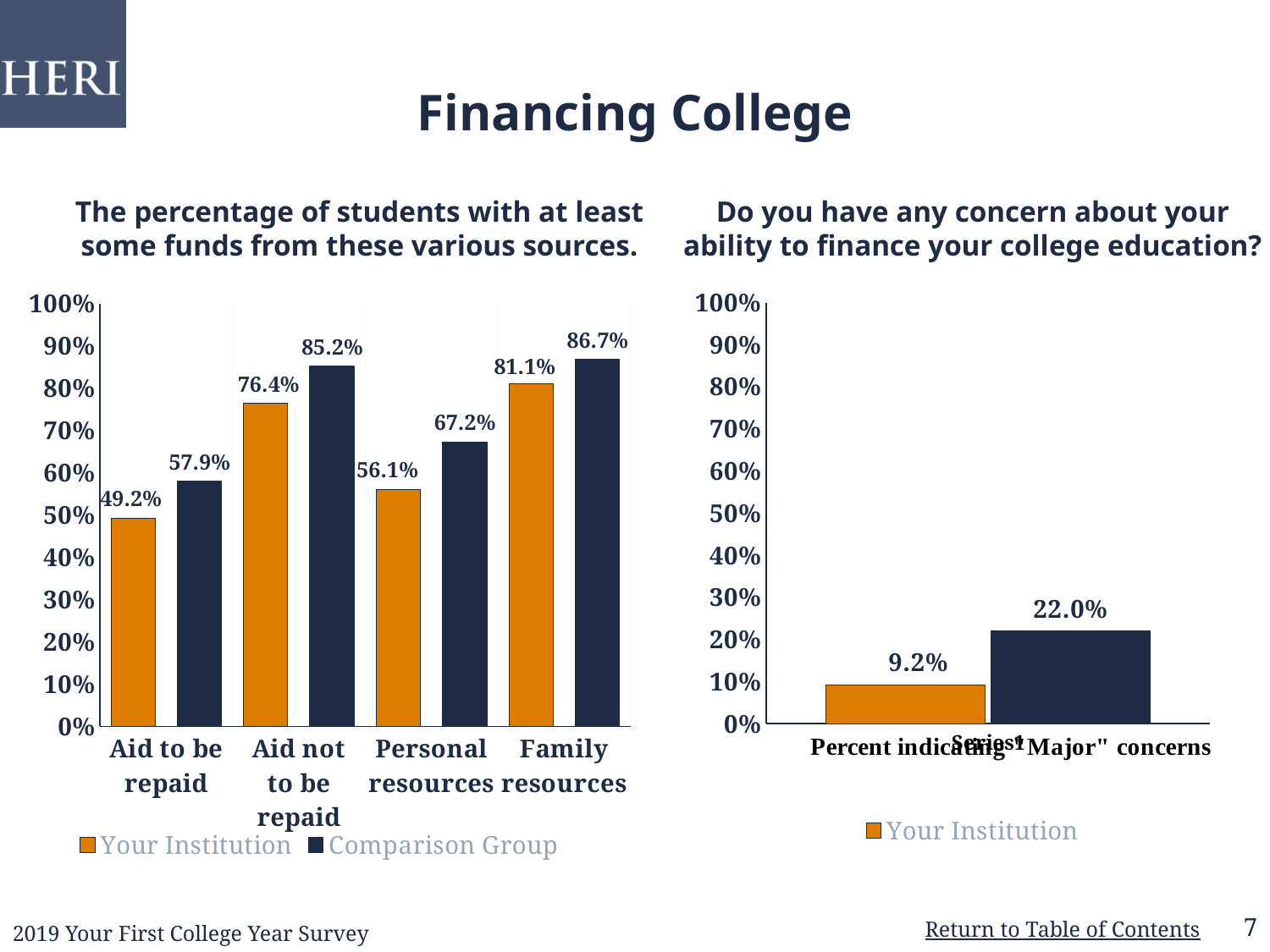
In the left chart, which is larger for Aid not to be repaid: Your Institution or Comparison Group? Comparison Group What kind of chart is the right chart? bar chart In the left chart, which category has the highest Comparison Group value? Family resources How many series does the legend of the left chart list? 2 In the left chart, what is the value for Your Institution for Personal resources? 56.1% In the right chart, what is the difference between the dark blue bar and the orange Your Institution bar? 12.8% In the left chart, which category has the lowest Your Institution value? Aid to be repaid In the left chart, what is the value for Comparison Group for Family resources? 86.7% How many categories are shown on the x axis of the left chart? 4 In the left chart, what is the value for Your Institution for Aid to be repaid? 49.2% In the left chart, what is the difference between the Comparison Group and Your Institution values for Personal resources? 11.1% In the right chart, what is the value of the orange bar labelled Your Institution? 9.2%